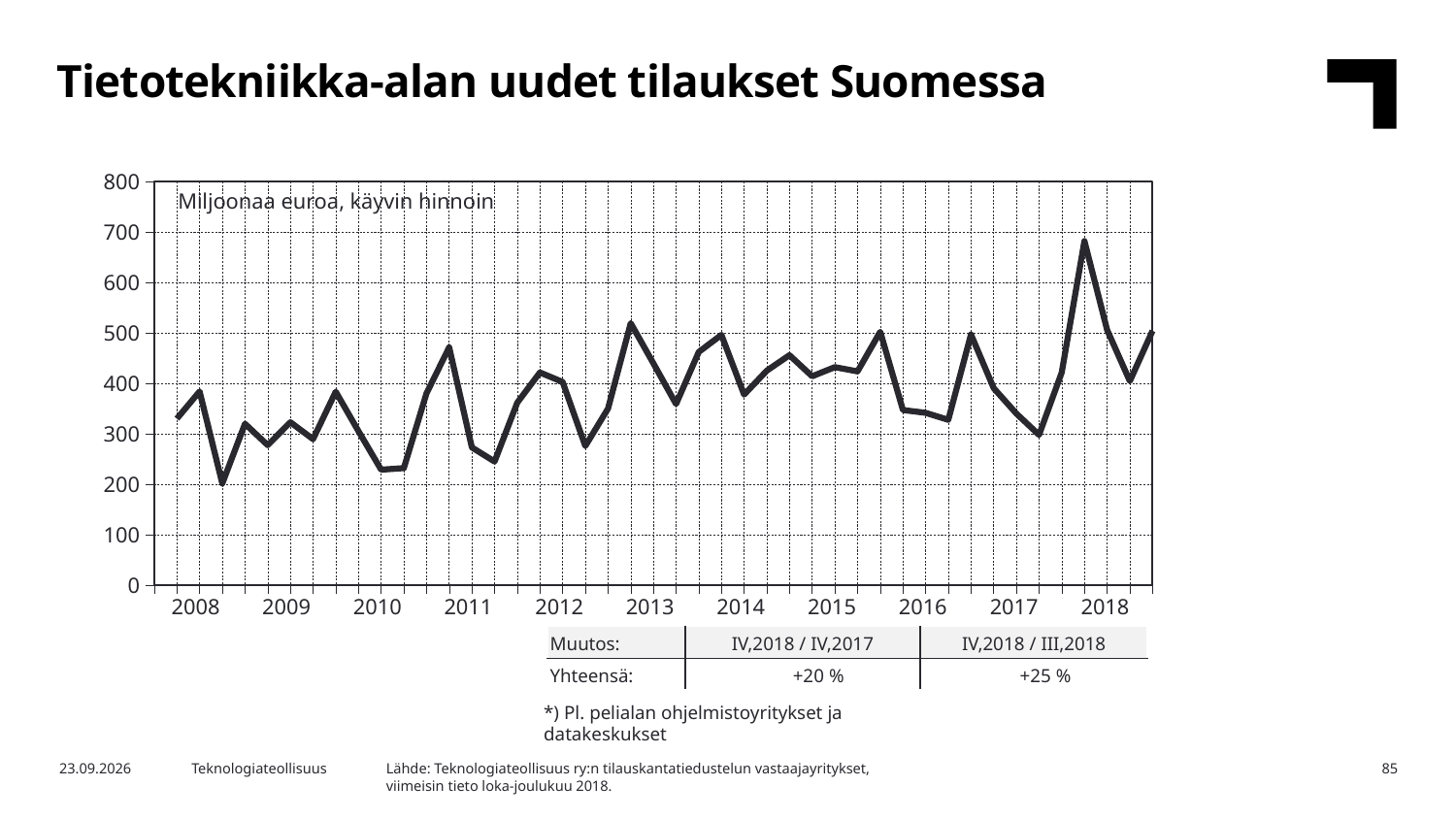
What is the change given in the table for IV,2018 / IV,2017? +20 % What is the title of the chart on the slide? Tietotekniikka-alan uudet tilaukset Suomessa Is the highest point of the line greater or less than 600? greater What kind of chart is shown on the slide? Line chart Does the line end in 2018 higher or lower than it starts in 2008? higher Is the value at the start of the line in 2008 greater or less than 400? less How many year labels are shown on the x axis? 11 What is the change given in the table for IV,2018 / III,2018? +25 % What is the highest value shown on the y axis? 800 What unit label is printed inside the chart area? Miljoonaa euroa, käyvin hinnoin How many lines (data series) are plotted in the chart? 1 Is the lowest point of the line greater or less than 300? less